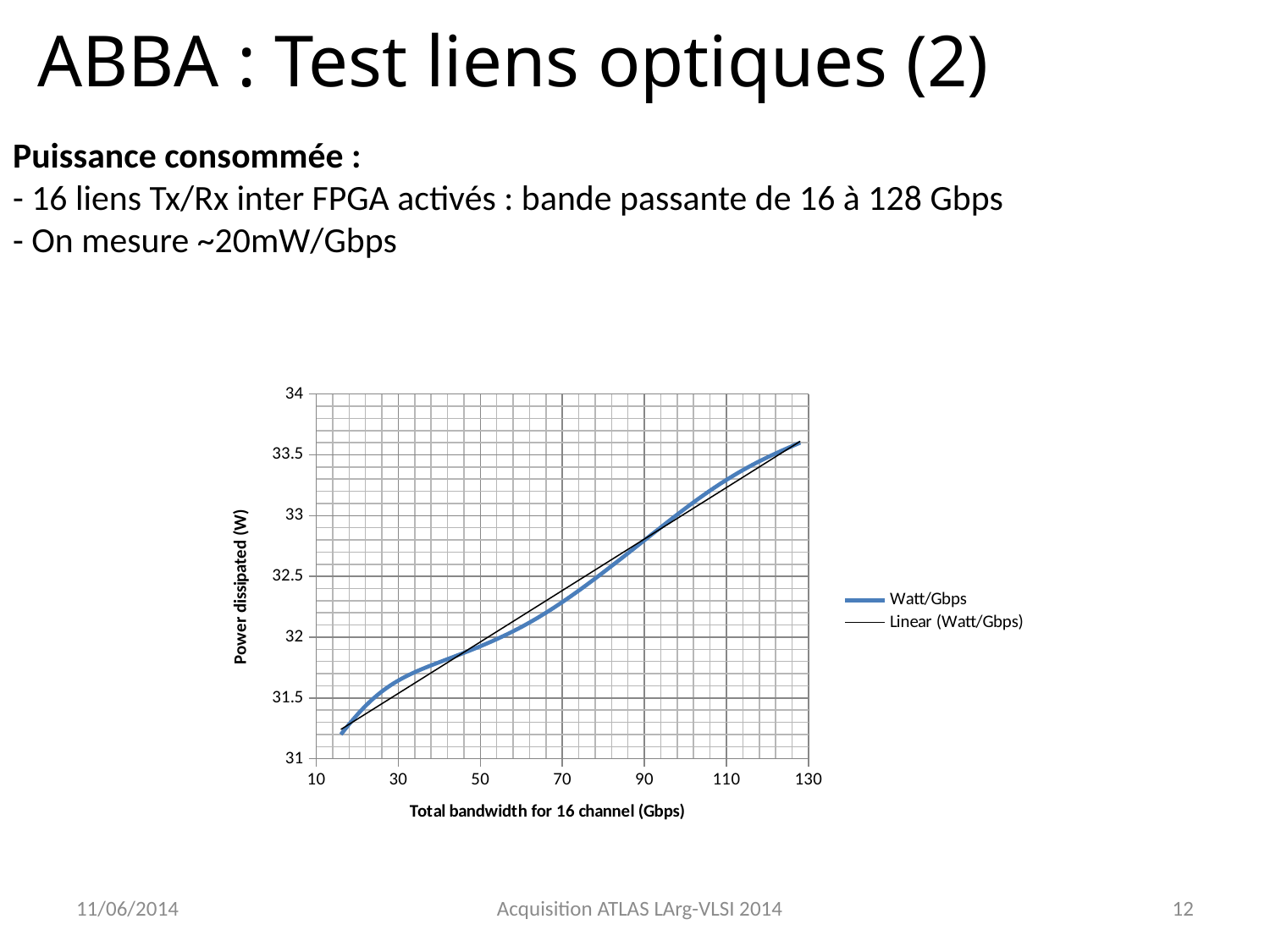
How many series does the chart legend list? 2 What kind of chart is shown on the slide? line chart Is the power dissipated at 70 Gbps greater or less than 32 W? greater Is the power dissipated at 110 Gbps greater or less than 33 W? greater Which has the larger power dissipated: 90 Gbps or 50 Gbps? 90 Gbps Is the power dissipated at 30 Gbps greater or less than 31.5 W? greater What are the two entries in the chart legend? Watt/Gbps and Linear (Watt/Gbps) What is the title of the chart's y axis? Power dissipated (W) Does the power dissipated rise or fall as the total bandwidth increases along the x axis? rise Which has the larger power dissipated: 30 Gbps or 110 Gbps? 110 Gbps